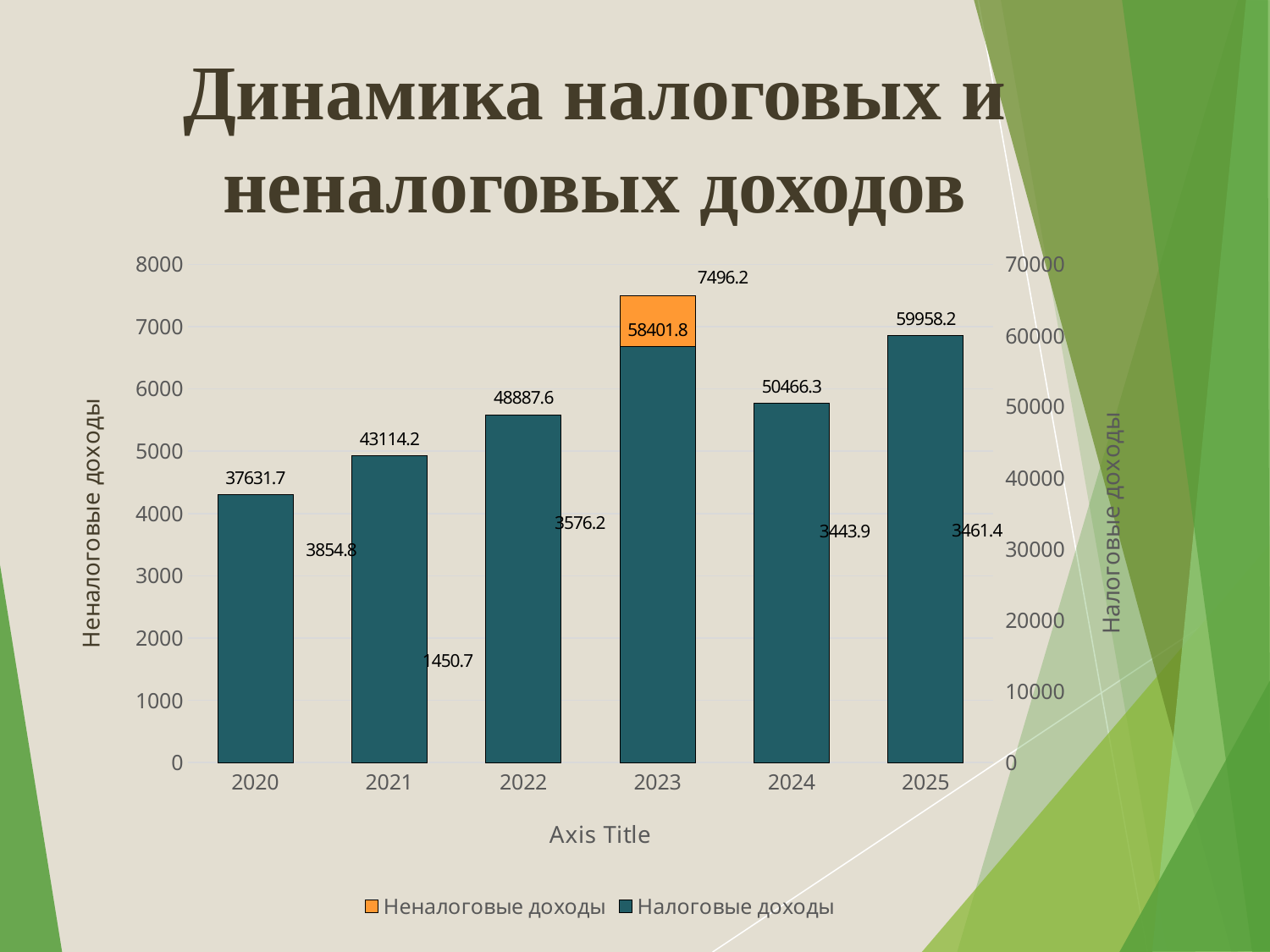
How many years are shown on the x axis? 6 Which year has the lowest value of Налоговые доходы? 2020 What is the value of Неналоговые доходы for 2021? 1450.7 How many series does the legend list? 2 Which year has the highest value of Налоговые доходы? 2025 What is the value of Неналоговые доходы for 2023? 7496.2 What is the value of Налоговые доходы for 2025? 59958.2 Which is larger, Налоговые доходы in 2022 or in 2024? 2024 What is the value of Налоговые доходы for 2020? 37631.7 What is the difference between Налоговые доходы in 2023 and 2024? 7935.5 What kind of chart is shown on the slide? Bar chart What is the title of the chart on the slide? Динамика налоговых и неналоговых доходов